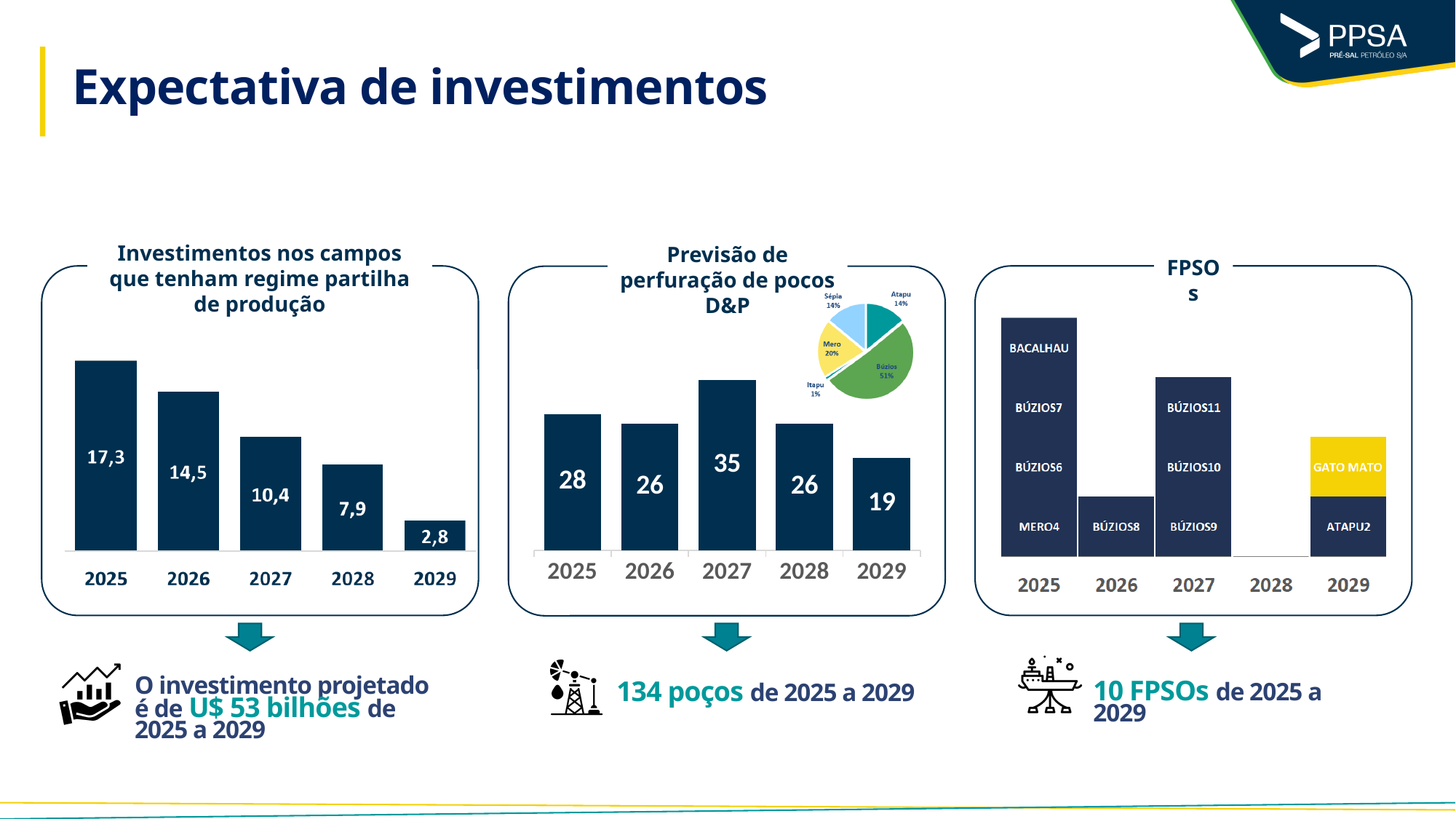
In the 'FPSOs' chart, how many FPSOs are stacked in the bar for 2025? 4 In the chart 'Investimentos nos campos que tenham regime partilha de produção', what is the difference between the values for 2026 and 2027? 4,1 In the chart 'Investimentos nos campos que tenham regime partilha de produção', which year has the lowest value? 2029 In the chart 'Investimentos nos campos que tenham regime partilha de produção', what is the value for 2025? 17,3 In the chart 'Previsão de perfuração de poços D&P', what is the difference between the values for 2025 and 2029? 9 In the pie chart inside the 'Previsão de perfuração de poços D&P' panel, what share does Búzios have? 51% In the pie chart inside the 'Previsão de perfuração de poços D&P' panel, which slice is the smallest? Itapu What kind of chart is the 'FPSOs' chart? stacked bar chart In the chart 'Previsão de perfuração de poços D&P', which year has the highest value? 2027 In the chart 'Investimentos nos campos que tenham regime partilha de produção', do the values rise or fall from 2025 to 2029? fall In the chart 'Previsão de perfuração de poços D&P', how many years are shown on the x axis? 5 In the chart 'Previsão de perfuração de poços D&P', what is the value for 2027? 35